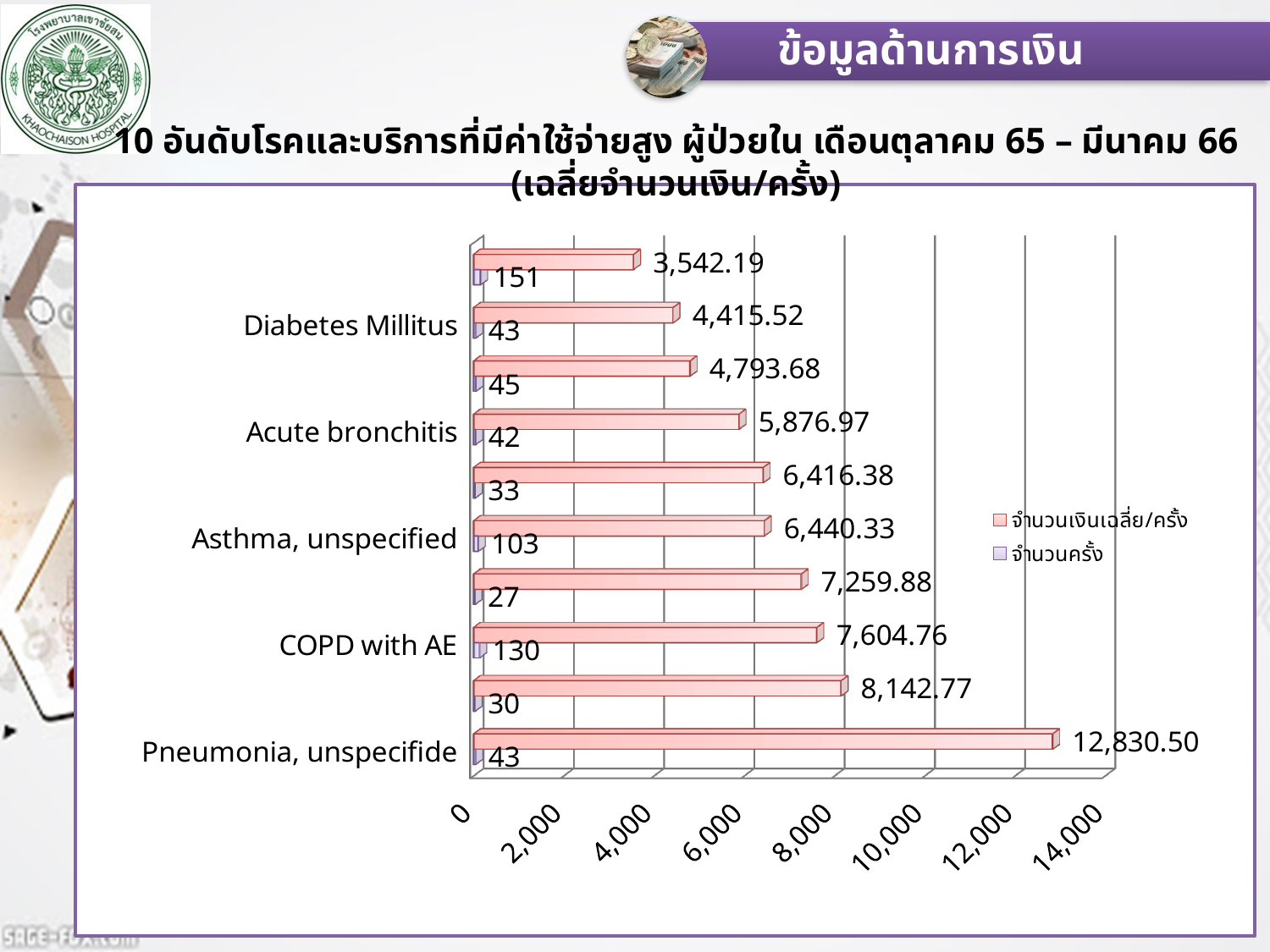
What is the average cost per visit (จำนวนเงินเฉลี่ย/ครั้ง) for Pneumonia, unspecifide? 12,830.50 What is the number of visits (จำนวนครั้ง) for COPD with AE? 130 Which has a higher average cost per visit, Asthma, unspecified or Acute bronchitis? Asthma, unspecified What is the number of visits for Asthma, unspecified? 103 How many categories (bar pairs) are plotted in the chart? 10 What is the average cost per visit for Diabetes Millitus? 4,415.52 What are the two legend entries of the chart? จำนวนเงินเฉลี่ย/ครั้ง and จำนวนครั้ง What kind of chart is shown on the slide? bar chart How many series does the legend list? 2 What is the difference in average cost per visit between Pneumonia, unspecifide and COPD with AE? 5,225.74 Is the average cost per visit for Pneumonia, unspecifide greater or less than 12,000? greater Which labelled category has the highest average cost per visit? Pneumonia, unspecifide